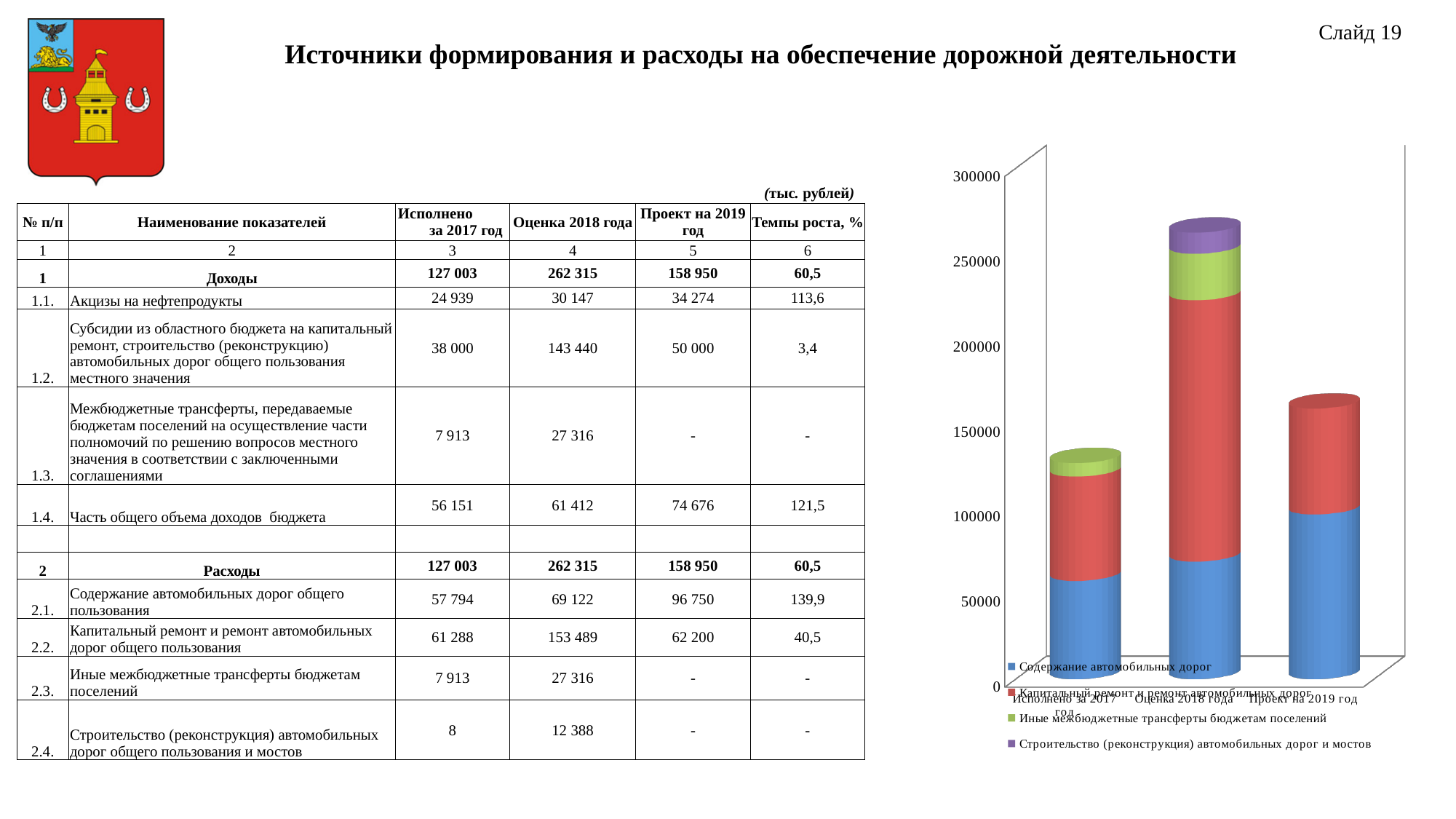
Does the total bar height rise or fall from Исполнено за 2017 год to Оценка 2018 года? rise What colour represents the series Содержание автомобильных дорог in the chart? blue How many categories are plotted along the x axis of the chart? 3 Is the total height of the bar for Исполнено за 2017 год greater or less than 150000? less Is the Содержание автомобильных дорог segment for Оценка 2018 года greater or less than 50000? greater What kind of chart is shown on the slide? stacked bar chart Which category has the shortest stacked bar in the chart? Исполнено за 2017 год Is the total height of the bar for Исполнено за 2017 год greater or less than 100000? greater How many series does the chart legend list? 4 Which category has the tallest stacked bar in the chart? Оценка 2018 года Which stacked bar is taller: Проект на 2019 год or Исполнено за 2017 год? Проект на 2019 год